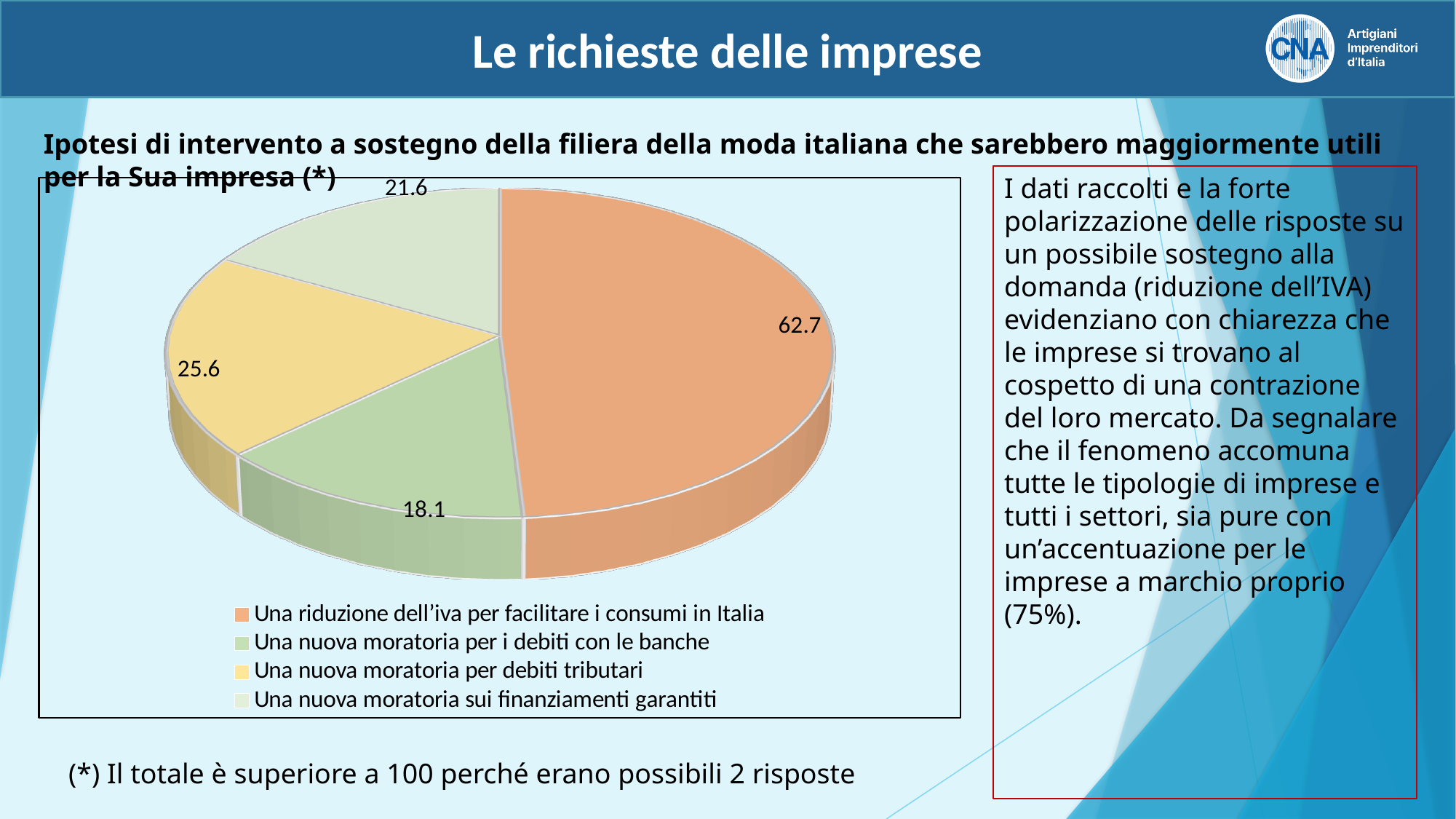
What value is shown for "Una nuova moratoria sui finanziamenti garantiti"? 21.6 Which colour represents "Una nuova moratoria per debiti tributari" in the legend? Yellow What value is shown for "Una nuova moratoria per debiti tributari"? 25.6 What value is shown for "Una nuova moratoria per i debiti con le banche"? 18.1 Which is larger: the value for "Una nuova moratoria per debiti tributari" or the value for "Una nuova moratoria per i debiti con le banche"? Una nuova moratoria per debiti tributari How many slices does the pie chart have? 4 What is the difference between the value for "Una riduzione dell'iva per facilitare i consumi in Italia" and the value for "Una nuova moratoria per debiti tributari"? 37.1 Which category has the highest value in the pie chart? Una riduzione dell'iva per facilitare i consumi in Italia What value is shown for "Una riduzione dell'iva per facilitare i consumi in Italia"? 62.7 Which category has the lowest value in the pie chart? Una nuova moratoria per i debiti con le banche What is the difference between the value for "Una nuova moratoria per debiti tributari" and the value for "Una nuova moratoria sui finanziamenti garantiti"? 4.0 What kind of chart is shown on the slide? Pie chart